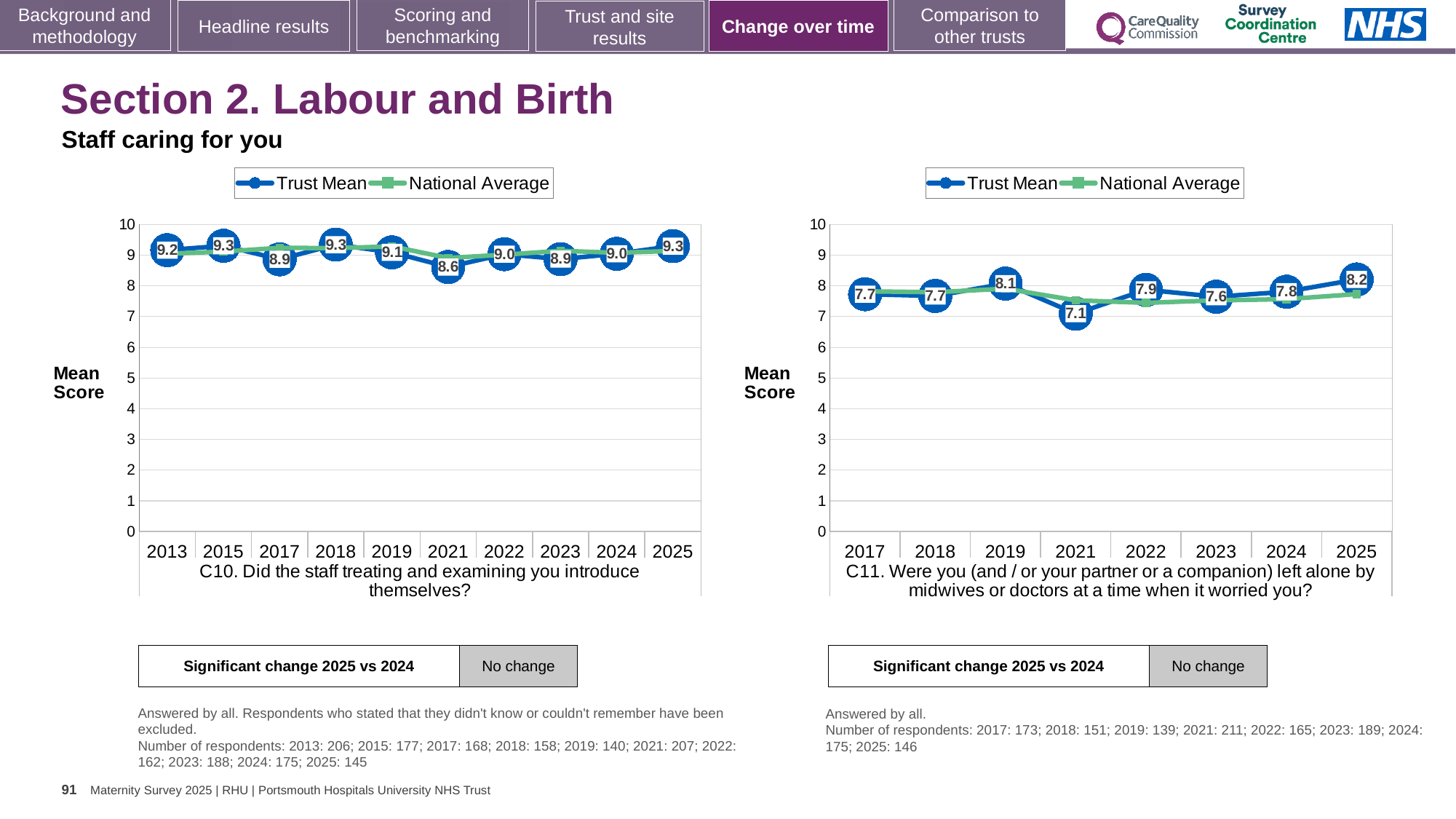
In the C11 chart, what is the difference between the Trust Mean scores for 2025 and 2021? 1.1 In the C11 chart, which year has the highest Trust Mean score? 2025 In the C11 chart, is the Trust Mean score higher in 2022 or in 2023? 2022 In the C10 chart, what is the difference between the Trust Mean scores for 2025 and 2021? 0.7 In the C10 chart, what is the Trust Mean score for 2025? 9.3 In the C11 chart, is the National Average value for 2025 greater or less than 8? less In the C10 chart, how many years are plotted on the x axis? 10 How many series does the legend of the C11 chart list? 2 In the C10 chart, which year has the lowest Trust Mean score? 2021 In the C10 chart, what is the Trust Mean score for 2021? 8.6 In the C11 chart, which year has the lowest Trust Mean score? 2021 In the C11 chart, what is the Trust Mean score for 2019? 8.1